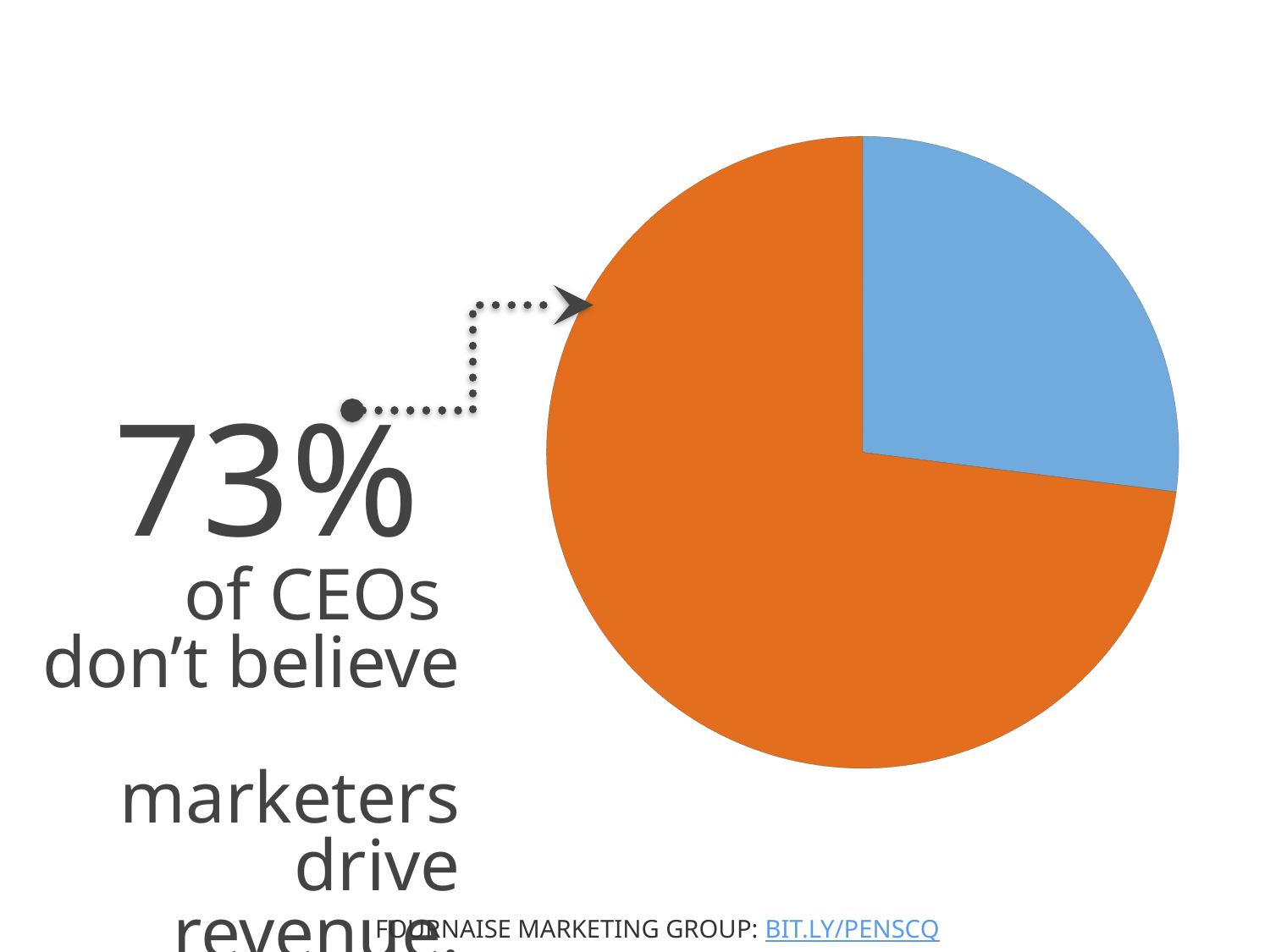
What type of chart is shown on the slide? pie chart Which slice of the pie chart is the smallest? the blue slice Which slice of the pie chart is the largest? the orange slice What percentage of CEOs don't believe marketers drive revenue, according to the slide? 73% Is the share of the orange slice greater or less than 50%? greater What does the orange slice of the pie chart represent? CEOs who don't believe marketers drive revenue What share of the pie does the orange slice represent? 73% Which is larger, the orange slice or the blue slice? the orange slice What source is cited for the data in the pie chart? Fournaise Marketing Group Is the share of the blue slice greater or less than 50%? less How many slices does the pie chart have? 2